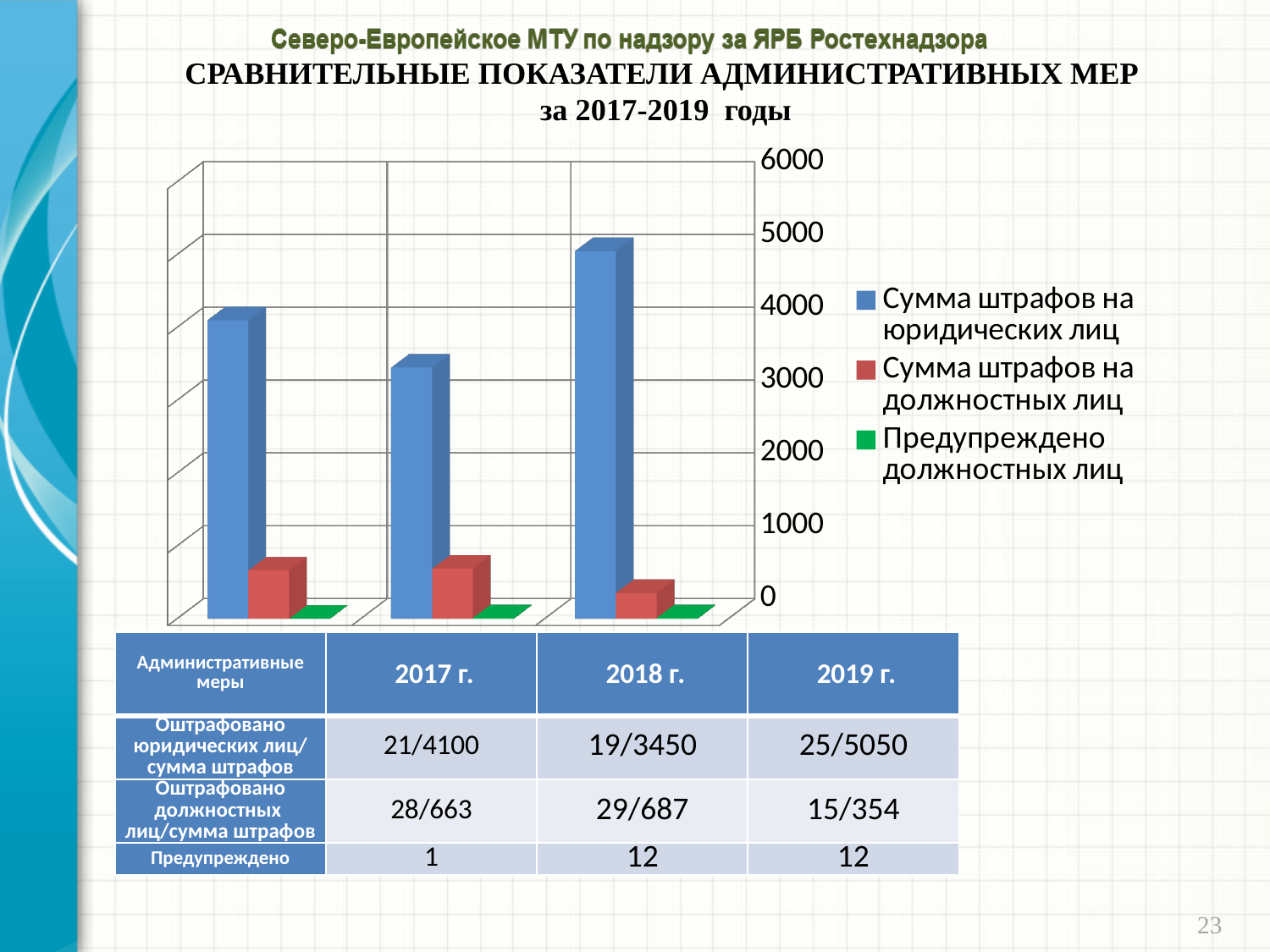
Which colour represents "Предупреждено должностных лиц" in the chart legend? green Which group of bars has the tallest blue bar (Сумма штрафов на юридических лиц)? the third group (2019) Is the value of the blue bar (Сумма штрафов на юридических лиц) in the third group greater or less than 4000? greater Is the value of the blue bar (Сумма штрафов на юридических лиц) in the first group greater or less than 3000? greater What kind of chart is shown on the slide? bar chart According to the table below the chart, what is the value for "Оштрафовано юридических лиц/сумма штрафов" in 2019? 25/5050 Which group of bars has the shortest blue bar (Сумма штрафов на юридических лиц)? the second group (2018) According to the table below the chart, what is the value for "Предупреждено" in 2018? 12 How many groups of bars are plotted in the chart? 3 Is the value of the blue bar (Сумма штрафов на юридических лиц) in the second group greater or less than 4000? less Is the red bar (Сумма штрафов на должностных лиц) larger in the first group or in the third group? the first group How many series does the chart legend list? 3